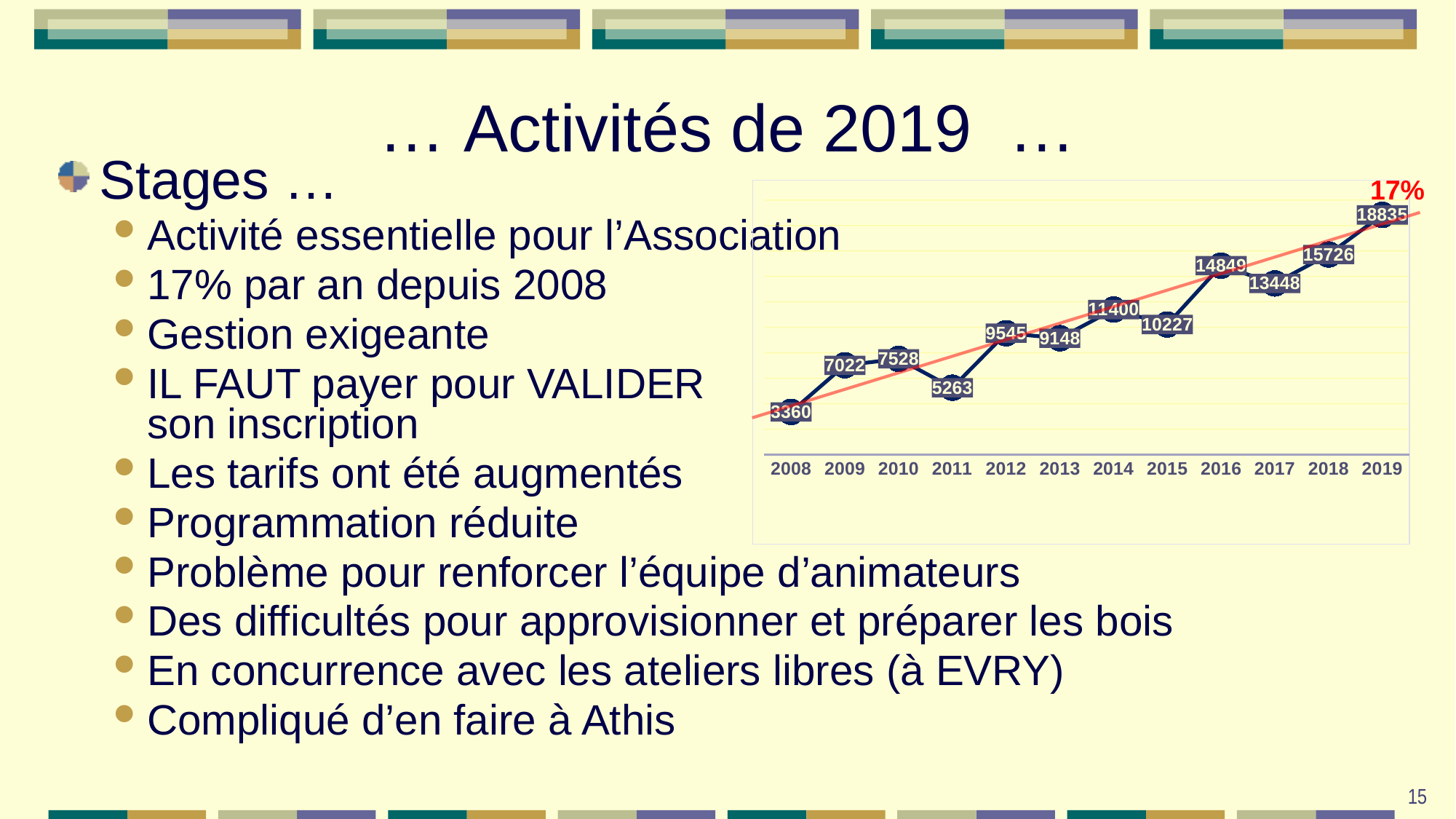
What kind of chart is shown on the slide? line chart Which is larger, the value for 2016 or the value for 2017? 2016 Do the values generally rise or fall from 2008 to 2019? rise What is the value for 2008? 3360 Which year has the highest value? 2019 What is the value for 2011? 5263 What percentage is written in red next to the trend line? 17% What is the value for 2016? 14849 How many years are plotted on the x axis? 12 Which year has the lowest value? 2008 What is the difference between the values for 2019 and 2018? 3109 What is the value for 2019? 18835